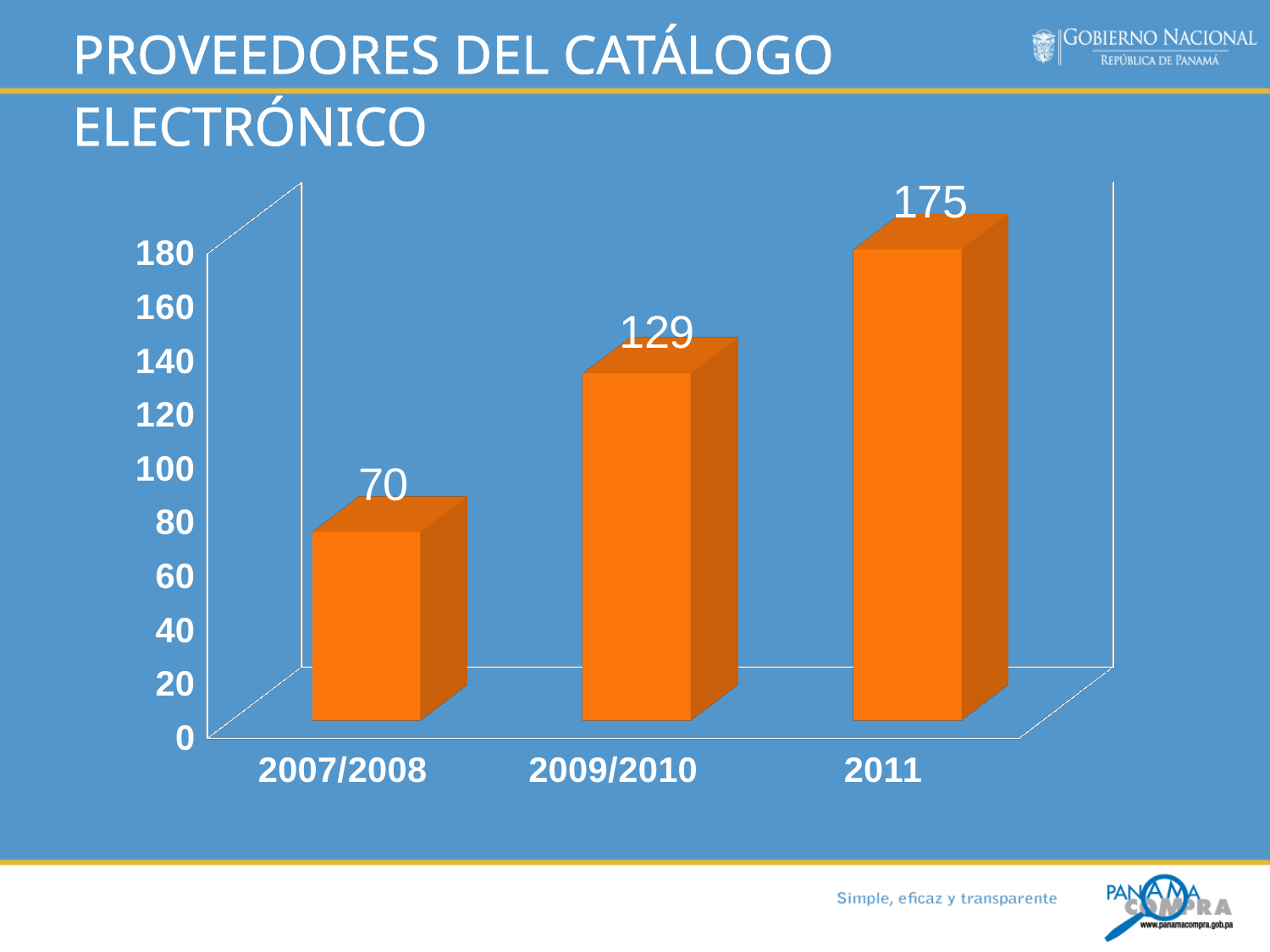
What is the value for 2007/2008? 70 How many categories are shown on the x axis? 3 Is the value for 2009/2010 greater or less than 100? greater Do the values rise or fall from 2007/2008 to 2011? rise What kind of chart is shown on the slide? bar chart Which category has the highest value? 2011 What is the difference between the values for 2011 and 2007/2008? 105 Which is larger, the value for 2009/2010 or the value for 2011? 2011 What is the value for 2009/2010? 129 What is the difference between the values for 2009/2010 and 2007/2008? 59 What is the value for 2011? 175 Which category has the lowest value? 2007/2008